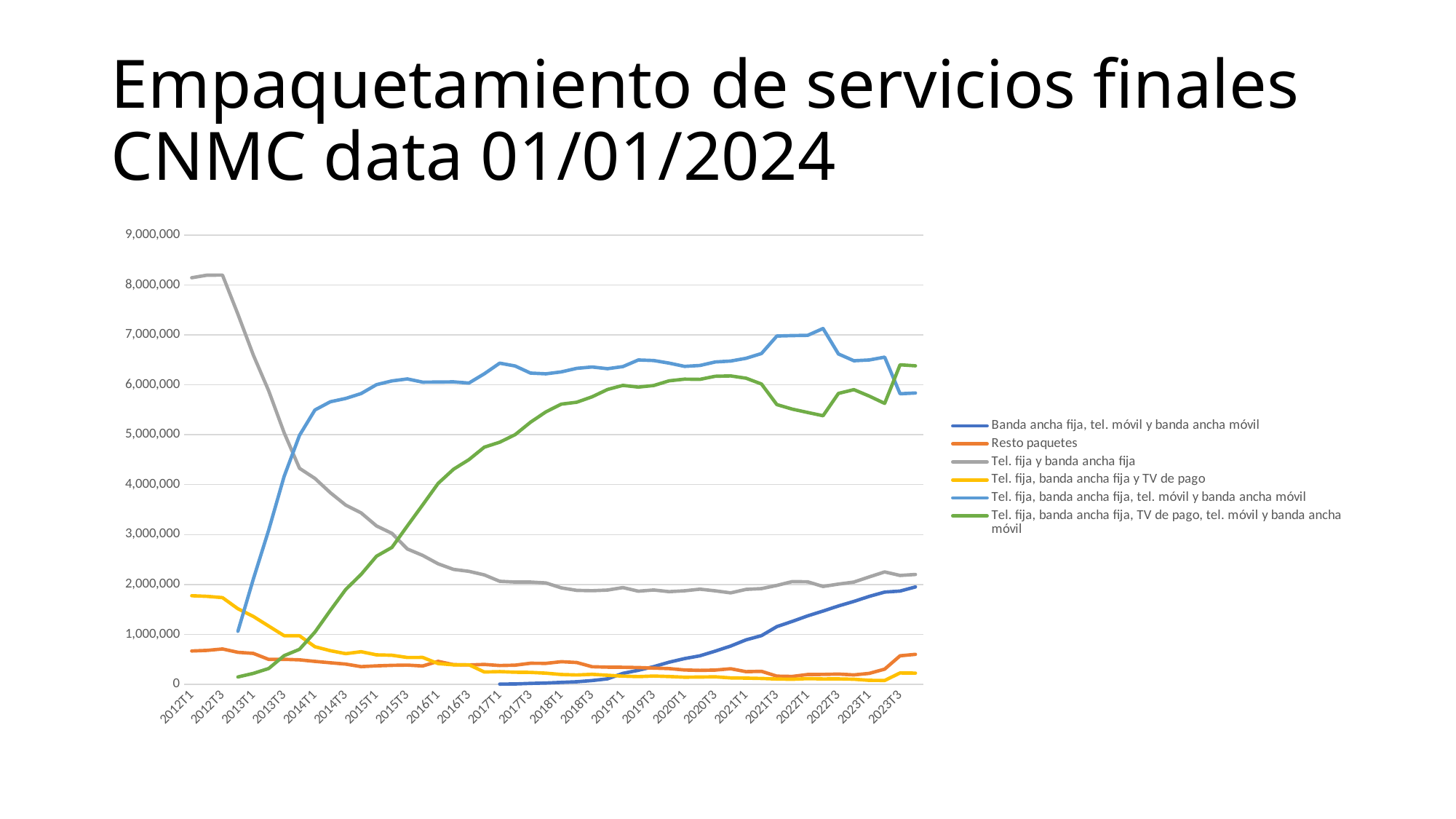
How many series does the legend list? 6 Is the value for Tel. fija y banda ancha fija at 2012T1 greater or less than 8,000,000? greater Is the value for Banda ancha fija, tel. móvil y banda ancha móvil at 2023T3 greater or less than 1,000,000? greater Is the value for Tel. fija, banda ancha fija y TV de pago at 2012T1 greater or less than 2,000,000? less Which series has the lowest value at 2023T3? Tel. fija, banda ancha fija y TV de pago Does the Tel. fija y banda ancha fija series rise or fall from 2012T1 to 2023T3? fall Which series has the highest value at 2012T1? Tel. fija y banda ancha fija What kind of chart is shown on the slide? line chart What is the title of the slide? Empaquetamiento de servicios finales CNMC data 01/01/2024 At 2023T3, which is larger: Tel. fija, banda ancha fija, TV de pago, tel. móvil y banda ancha móvil or Tel. fija, banda ancha fija, tel. móvil y banda ancha móvil? Tel. fija, banda ancha fija, TV de pago, tel. móvil y banda ancha móvil Does the Banda ancha fija, tel. móvil y banda ancha móvil series rise or fall from 2017T1 to 2023T3? rise